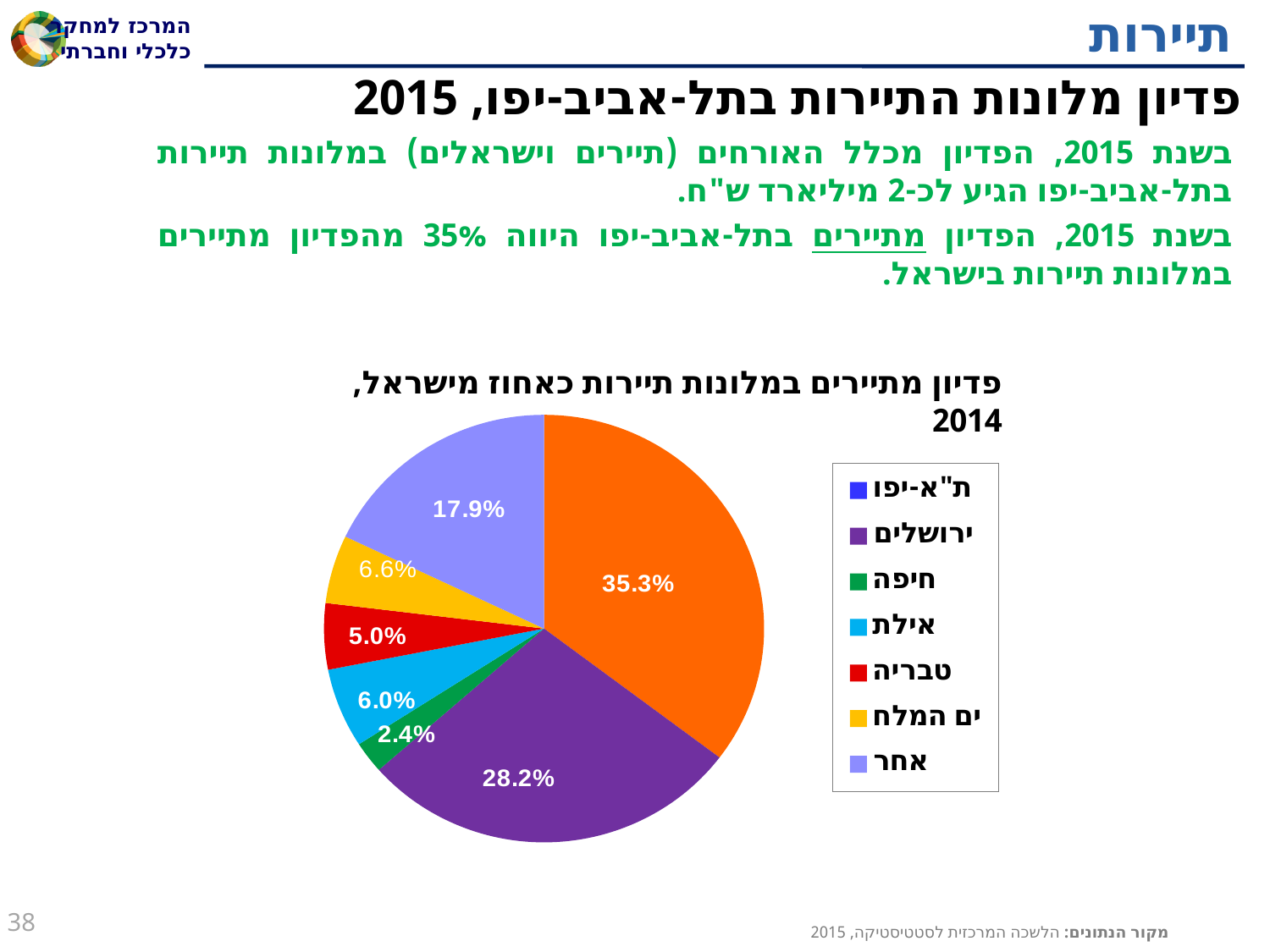
What percentage does the pie chart show for אחר? 17.9% What is the value of the largest slice in the pie chart? 35.3% What percentage does the pie chart show for ירושלים? 28.2% What percentage does the pie chart show for אילת? 6.0% What percentage does the pie chart show for טבריה? 5.0% What percentage does the pie chart show for חיפה? 2.4% What percentage does the pie chart show for ים המלח? 6.6% What kind of chart is shown on the slide? pie chart Which category has the smallest slice in the pie chart? חיפה How many slices does the pie chart have? 7 What is the difference between the shares of ירושלים and אחר? 10.3%